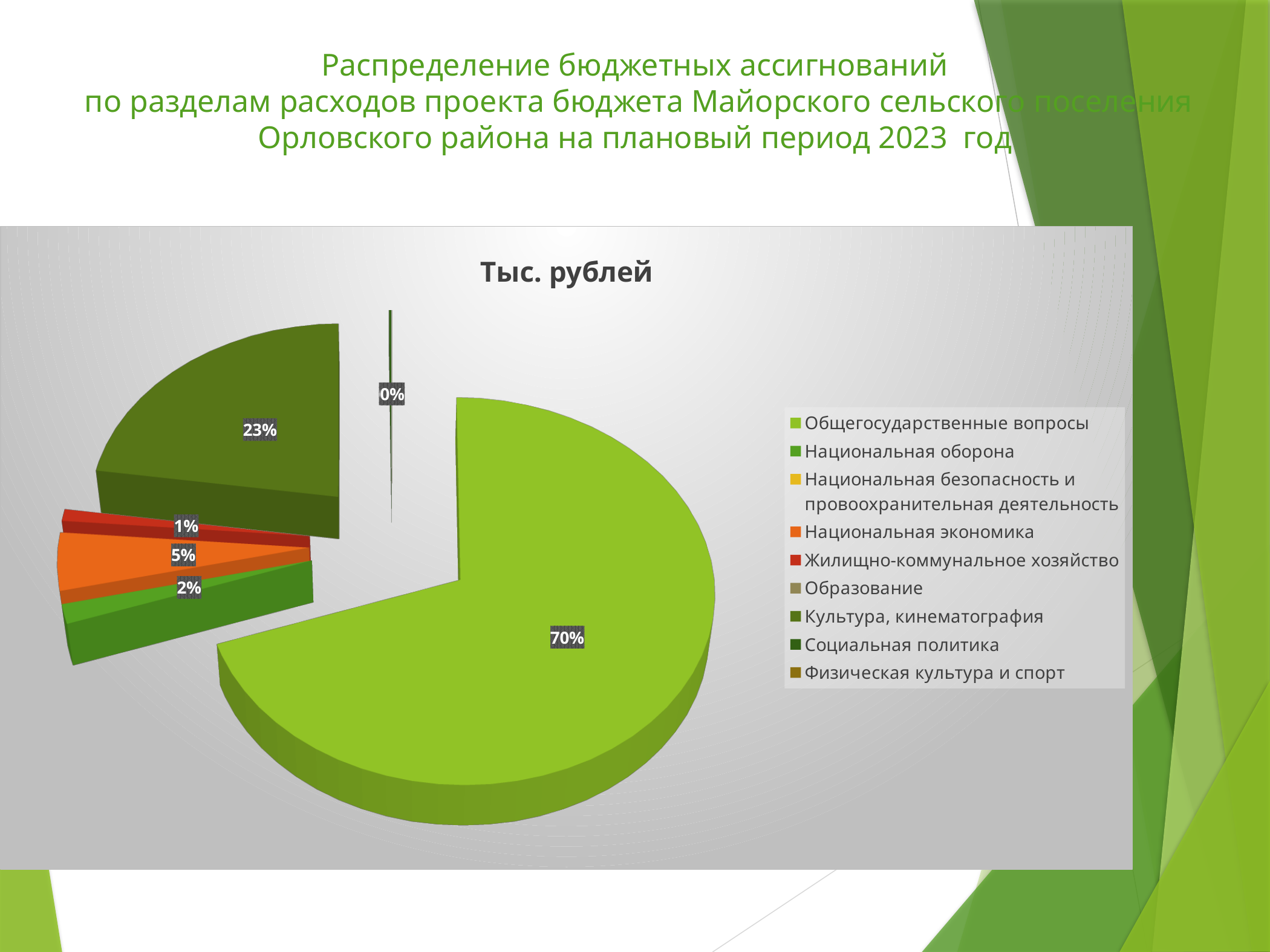
What share of the pie does Жилищно-коммунальное хозяйство have? 1% How many categories does the legend list? 9 Which category has the largest slice of the pie? Общегосударственные вопросы By how many percentage points does the share of Общегосударственные вопросы exceed that of Культура, кинематография? 47 percentage points Which has the larger share: Национальная экономика or Национальная оборона? Национальная экономика What share of the pie does Национальная экономика have? 5% What share of the pie does Культура, кинематография have? 23% What share of the pie does Национальная оборона have? 2% What is the title of the chart? Тыс. рублей What share of the pie does Общегосударственные вопросы have? 70% What is the difference in percentage points between the shares of Национальная экономика and Жилищно-коммунальное хозяйство? 4 percentage points What kind of chart is shown on the slide? pie chart